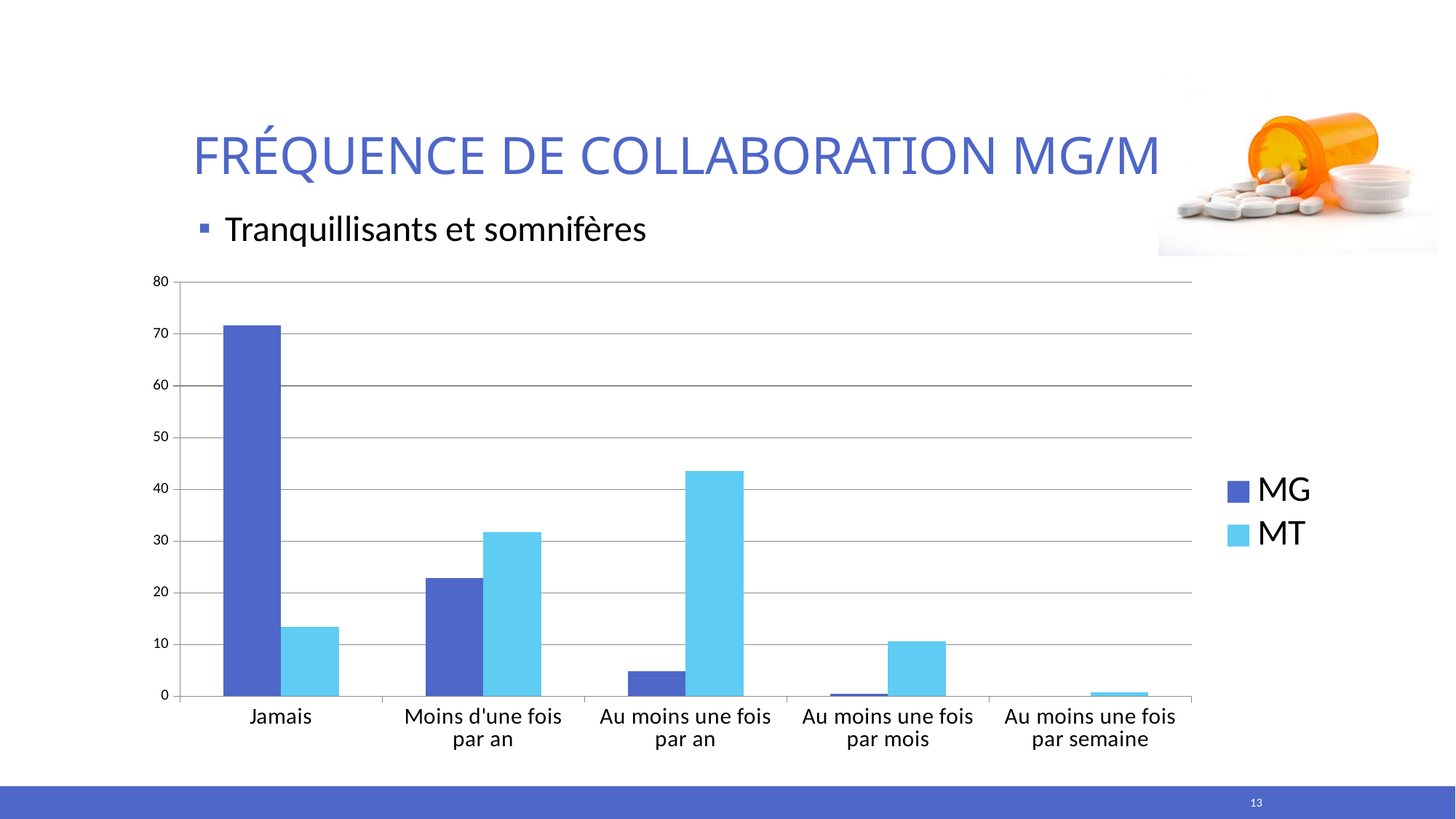
Do the MG values rise or fall moving from Jamais to Au moins une fois par semaine along the x axis? fall Which category has the highest value for the MG series? Jamais Which category has the lowest value for the MT series? Au moins une fois par semaine What are the two entries listed in the legend? MG and MT How many categories are shown on the x axis? 5 Which category has the highest value for the MT series? Au moins une fois par an Is the MT value for Au moins une fois par an greater or less than 40? greater Is the MG value for Jamais greater or less than 70? greater What kind of chart is shown on the slide? bar chart For the category Au moins une fois par an, which series has the larger value, MG or MT? MT How many series does the legend list? 2 For the category Jamais, which series has the larger value, MG or MT? MG